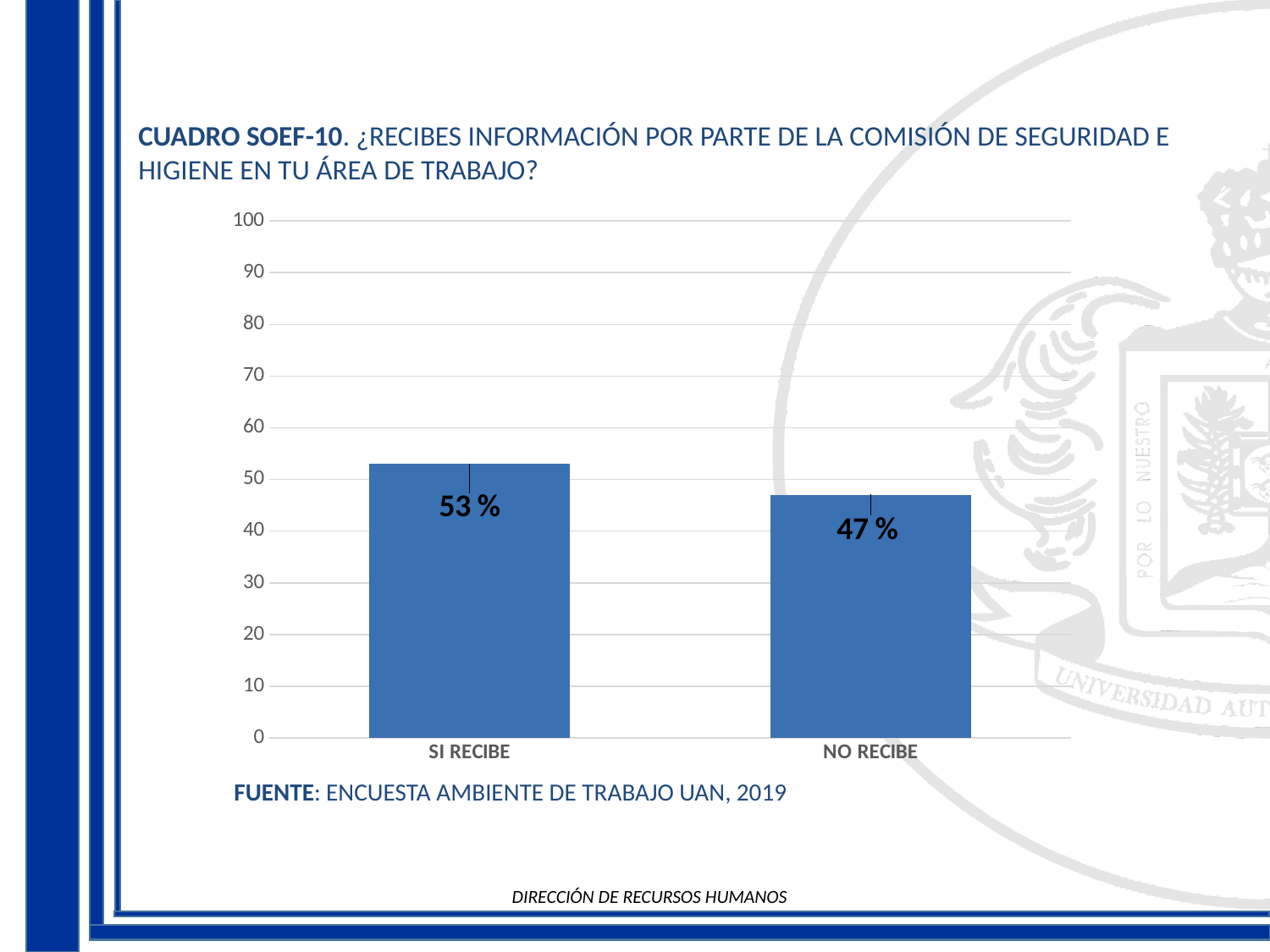
What is the difference between the values for SI RECIBE and NO RECIBE? 6 % What is the value for NO RECIBE? 47 % Is the value for NO RECIBE greater or less than 50? less Which category has the lowest value? NO RECIBE What is the value for SI RECIBE? 53 % What is the maximum value shown on the y axis? 100 How many categories are shown on the x axis? 2 Which category has the highest value? SI RECIBE What kind of chart is shown on the slide? bar chart What source is cited below the chart? ENCUESTA AMBIENTE DE TRABAJO UAN, 2019 Is the value for SI RECIBE greater or less than 50? greater Which is larger, the value for SI RECIBE or NO RECIBE? SI RECIBE